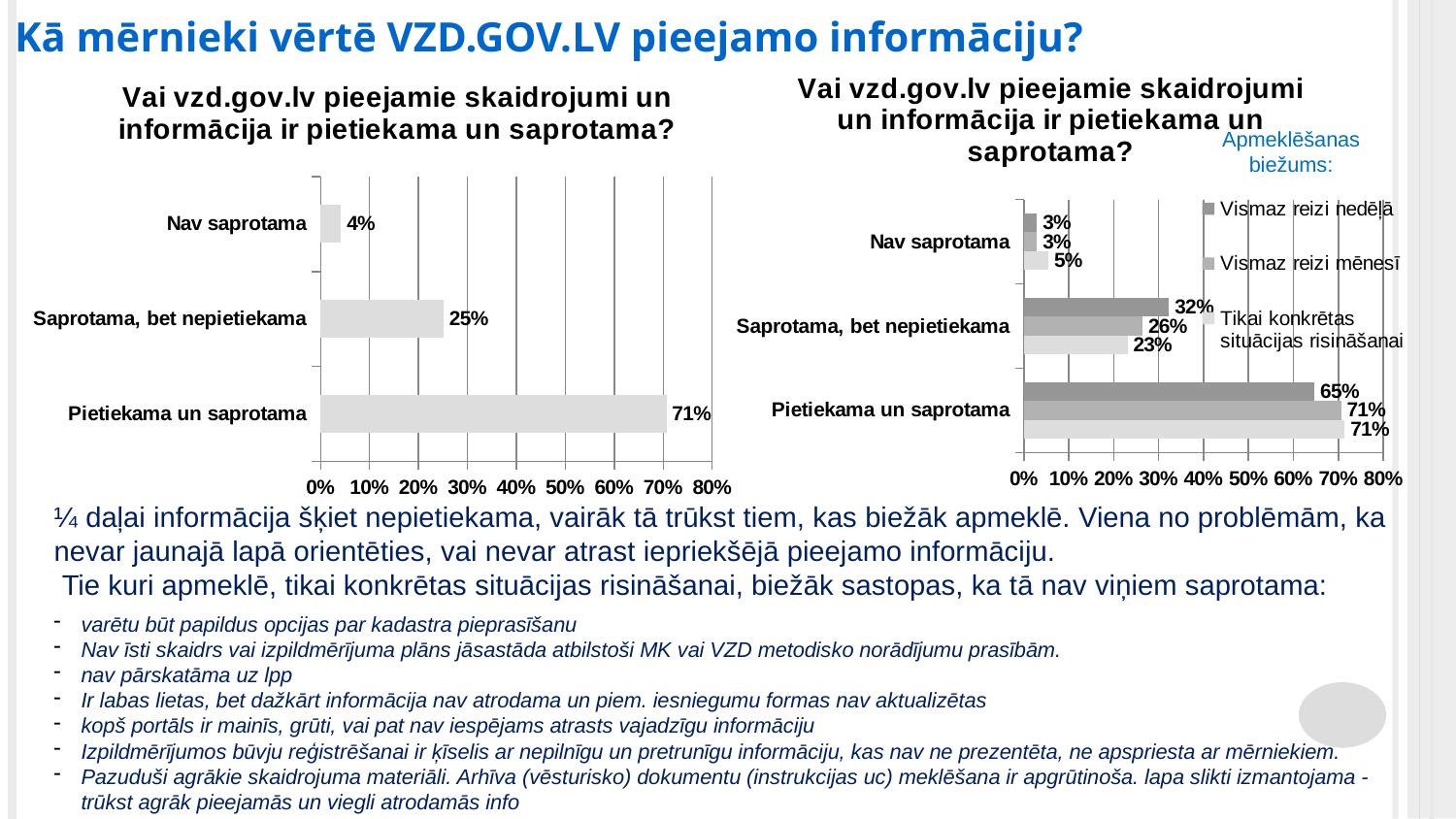
In the left chart, which category has the lowest value? Nav saprotama How many categories does the left chart show? 3 In the left chart, what is the value for "Nav saprotama"? 4% In the left chart, what is the difference between "Pietiekama un saprotama" and "Saprotama, bet nepietiekama"? 46% In the right chart, what is the value for "Nav saprotama" in the "Tikai konkrētas situācijas risināšanai" series? 5% In the right chart, which series has the highest value for "Saprotama, bet nepietiekama"? Vismaz reizi nedēļā In the left chart, what is the value for "Pietiekama un saprotama"? 71% In the right chart, what is the value for "Saprotama, bet nepietiekama" in the "Vismaz reizi nedēļā" series? 32% In the right chart, what is the value for "Pietiekama un saprotama" in the "Vismaz reizi nedēļā" series? 65% What kind of chart is the left chart? Bar chart How many series does the legend of the right chart list? 3 In the right chart, is the value for "Saprotama, bet nepietiekama" in the "Vismaz reizi nedēļā" series larger or smaller than in the "Tikai konkrētas situācijas risināšanai" series? Larger